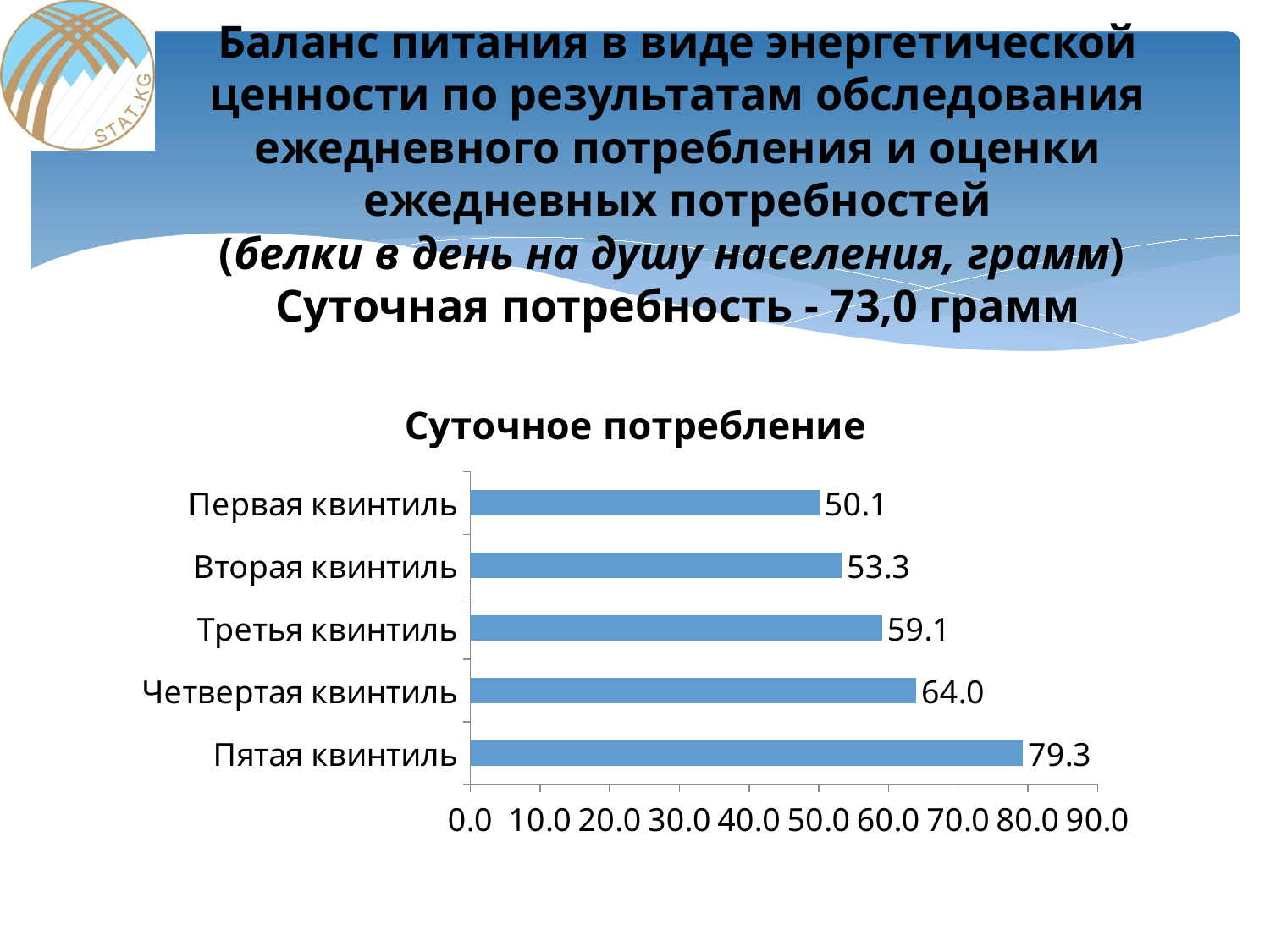
Which category has the highest value? Пятая квинтиль What kind of chart is shown on the slide? bar chart What is the difference between the values for Четвертая квинтиль and Вторая квинтиль? 10.7 What is the value for Пятая квинтиль? 79.3 What is the title of the chart? Суточное потребление Which is larger, the value for Третья квинтиль or Вторая квинтиль? Третья квинтиль How many categories are shown in the chart? 5 Which category has the lowest value? Первая квинтиль What is the value for Первая квинтиль? 50.1 What is the difference between the values for Пятая квинтиль and Первая квинтиль? 29.2 Is the value for Четвертая квинтиль greater or less than 60.0? greater What is the value for Третья квинтиль? 59.1